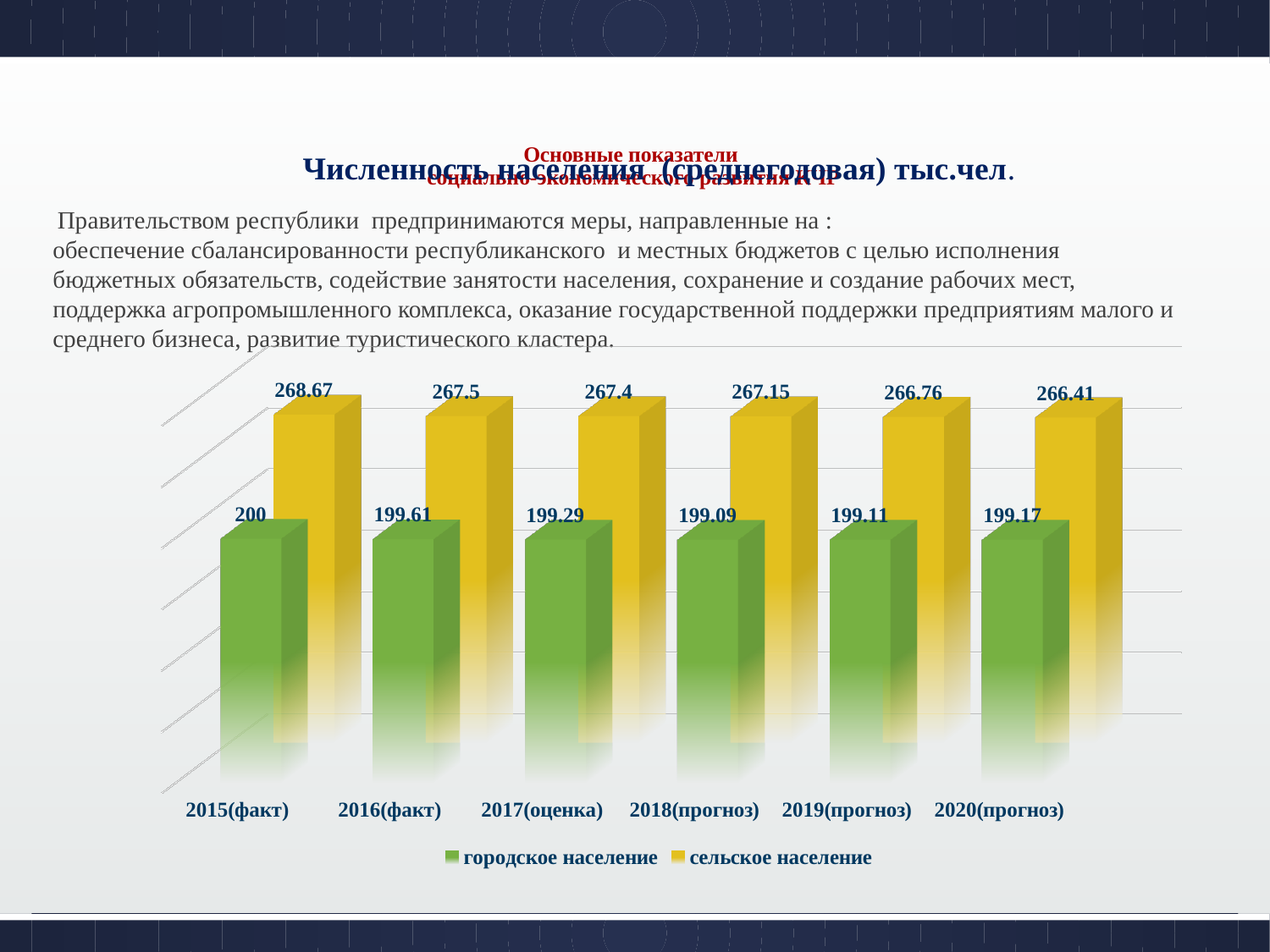
What is the value for сельское население in 2018(прогноз)? 267.15 What is the value for городское население in 2015(факт)? 200 Which is larger in 2019(прогноз): городское население or сельское население? сельское население How many years (categories) are shown on the x axis? 6 What is the value for городское население in 2020(прогноз)? 199.17 What is the difference between сельское население in 2015(факт) and in 2020(прогноз)? 2.26 What is the value for сельское население in 2016(факт)? 267.5 What is the difference between сельское население and городское население in 2015(факт)? 68.67 How many series does the legend list? 2 What kind of chart is shown on the slide? bar chart In which year is сельское население highest? 2015(факт) In which year is сельское население lowest? 2020(прогноз)